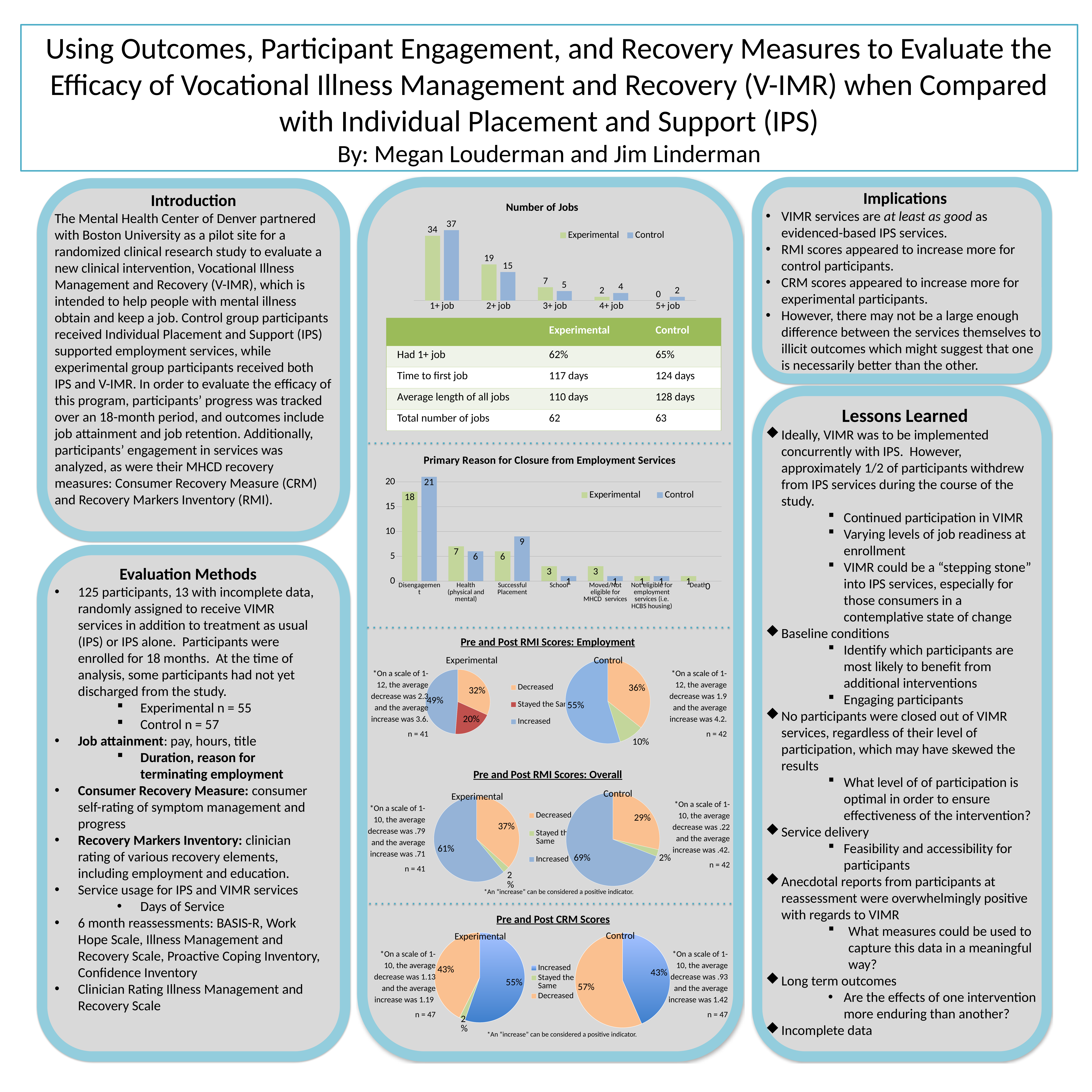
In the "Number of Jobs" chart, what is the Experimental value for 2+ job? 19 In the "Pre and Post CRM Scores" Control pie chart, what share is Decreased? 57% In the "Pre and Post RMI Scores: Employment" Experimental pie chart, what share is Stayed the Same? 20% In the "Pre and Post RMI Scores: Overall" Control pie chart, what share is Increased? 69% In the "Primary Reason for Closure from Employment Services" chart, what is the Control value for Successful Placement? 9 In the "Number of Jobs" chart, how many series does the legend list? 2 In the "Primary Reason for Closure from Employment Services" chart, which is larger for Health (physical and mental): Experimental or Control? Experimental What kind of chart is the "Primary Reason for Closure from Employment Services" chart? bar chart In the "Primary Reason for Closure from Employment Services" chart, how many categories are shown on the x axis? 7 In the "Number of Jobs" chart, what is the Control value for 1+ job? 37 In the "Primary Reason for Closure from Employment Services" chart, which category has the highest Control value? Disengagement In the "Number of Jobs" chart, what is the difference between the Experimental and Control values for 2+ job? 4